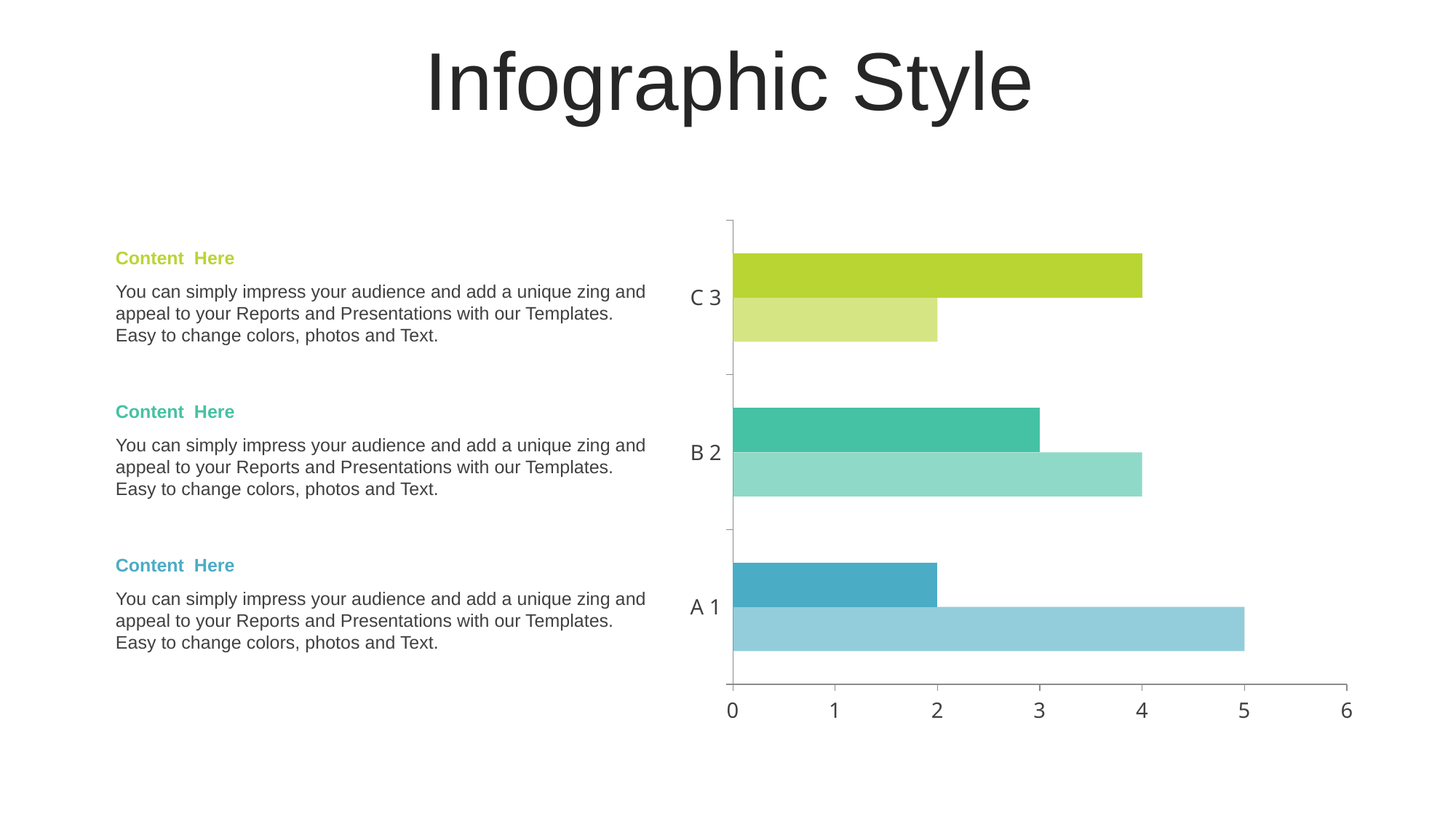
What is the value of the upper (darker) bar for category A 1? 2 Which is larger for category C 3: the upper bar or the lower bar? the upper bar What is the value of the upper (darker) bar for category B 2? 3 Which category has the longest bar on the chart? A 1 What is the value of the lower (lighter) bar for category B 2? 4 What is the value of the upper (darker) bar for category C 3? 4 What is the difference between the lower bar and the upper bar for category A 1? 3 What kind of chart is shown on the slide? bar chart What is the value of the lower (lighter) bar for category A 1? 5 What is the highest value shown on the chart's horizontal axis? 6 How many categories are shown on the chart's vertical axis? 3 What is the value of the lower (lighter) bar for category C 3? 2